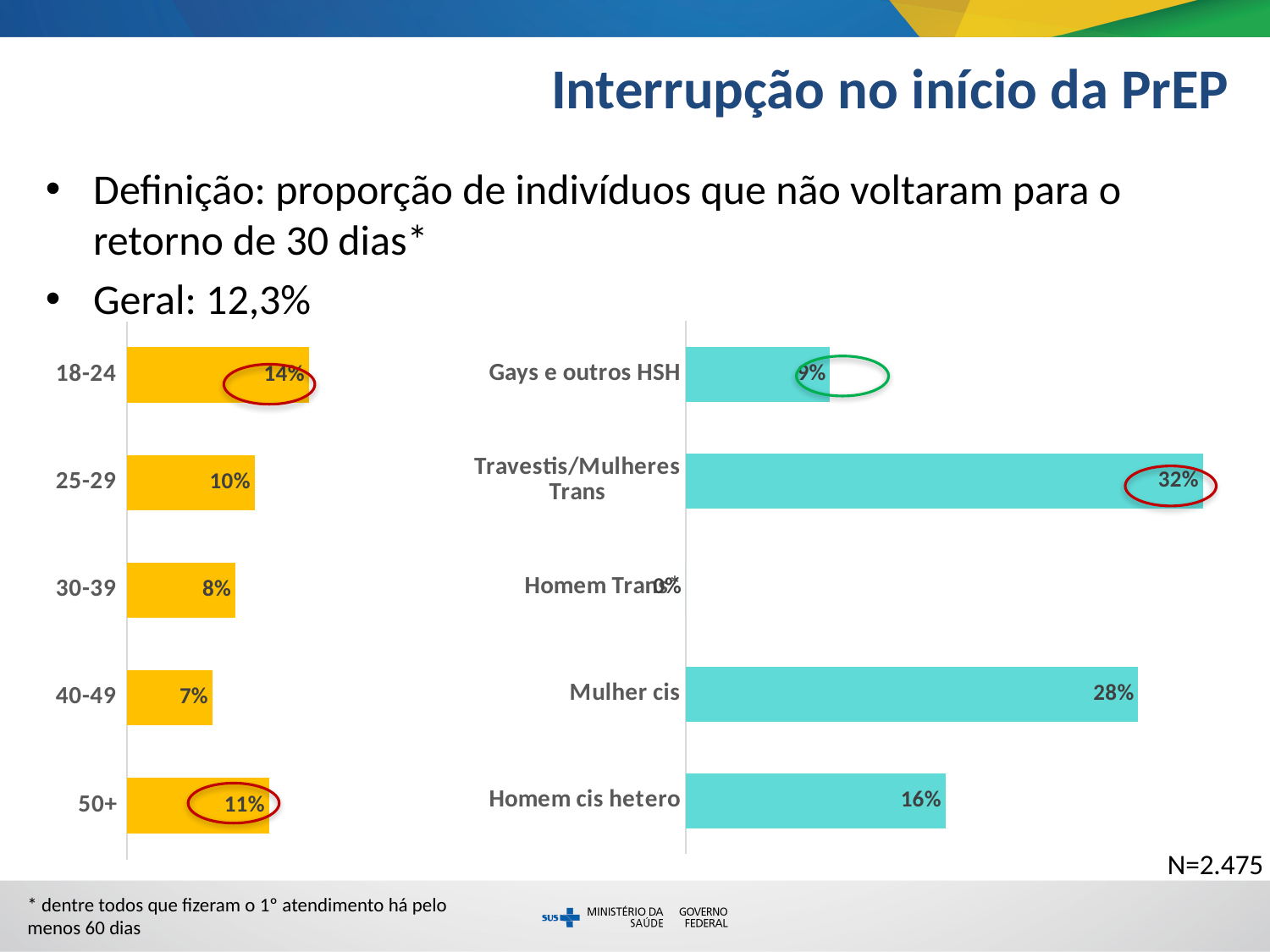
What type of chart is the right chart (population groups)? Bar chart In the right chart (population groups), what is the difference between the values for Mulher cis and Homem cis hetero? 12% In the left chart (age groups), how many age groups are shown? 5 In the left chart (age groups), what is the value for the 18-24 group? 14% In the right chart (population groups), which group has the highest value? Travestis/Mulheres Trans In the left chart (age groups), what is the value for the 40-49 group? 7% In the left chart (age groups), which age group has the highest value? 18-24 In the left chart (age groups), which age group has the lowest value? 40-49 In the left chart (age groups), what is the difference between the values for 18-24 and 30-39? 6% In the right chart (population groups), what is the value for Homem cis hetero? 16% In the right chart (population groups), which is larger, the value for Mulher cis or the value for Gays e outros HSH? Mulher cis In the right chart (population groups), what is the value for Travestis/Mulheres Trans? 32%